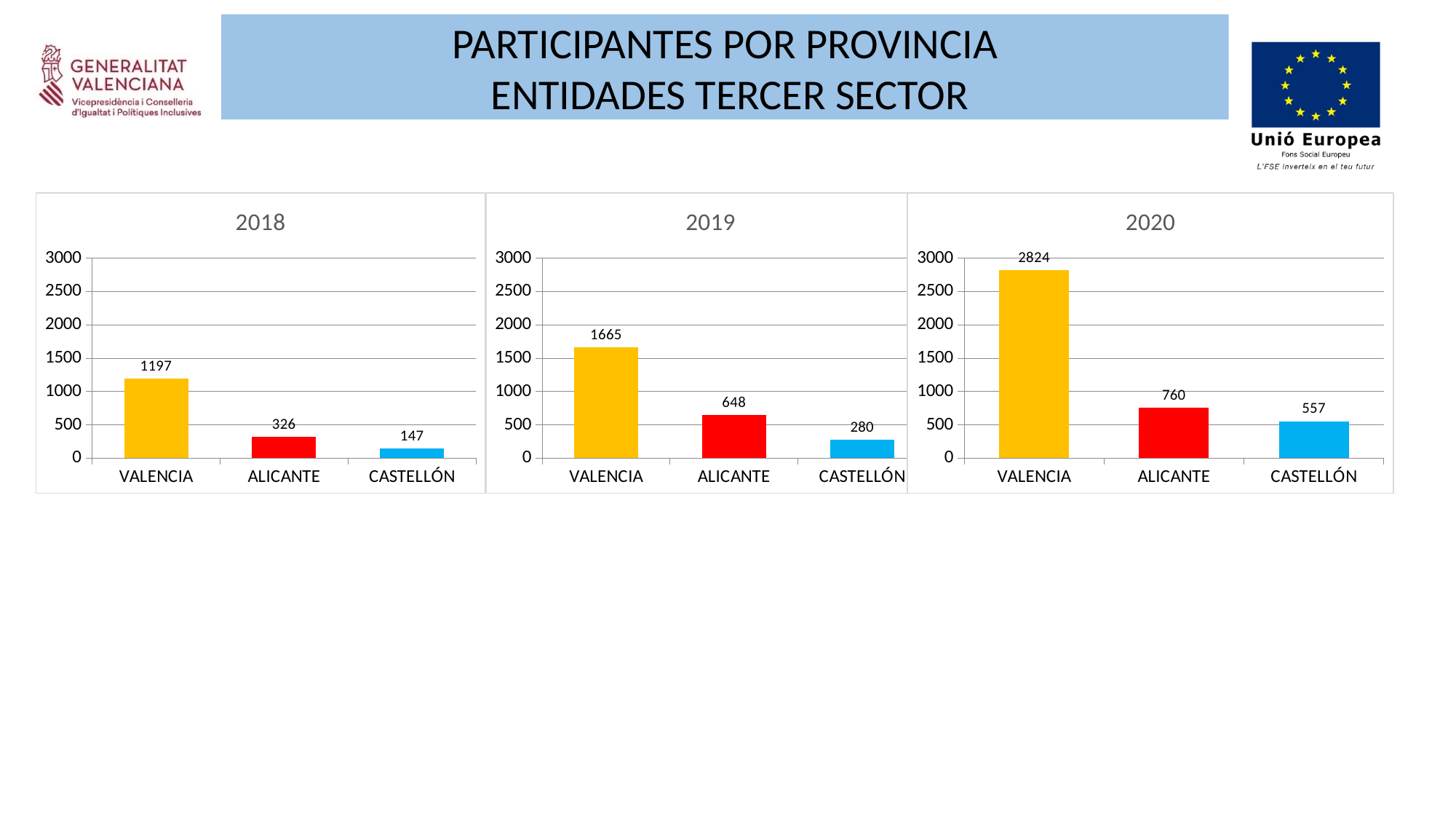
In the 2018 chart, which province has the lowest value? CASTELLÓN In the 2020 chart, what is the value for CASTELLÓN? 557 What kind of chart is the 2018 chart? bar chart In the 2019 chart, what is the value for ALICANTE? 648 In the 2018 chart, what is the value for VALENCIA? 1197 Which is larger: the value for ALICANTE in the 2018 chart or the value for CASTELLÓN in the 2019 chart? ALICANTE in 2018 In the 2019 chart, what is the difference between the values for VALENCIA and ALICANTE? 1017 How many provinces are shown in the 2019 chart? 3 In the 2020 chart, is the value for VALENCIA greater or less than 2500? greater What is the title of the chart on the right of the slide? 2020 In the 2020 chart, which province has the highest value? VALENCIA In the 2020 chart, what is the difference between the values for ALICANTE and CASTELLÓN? 203